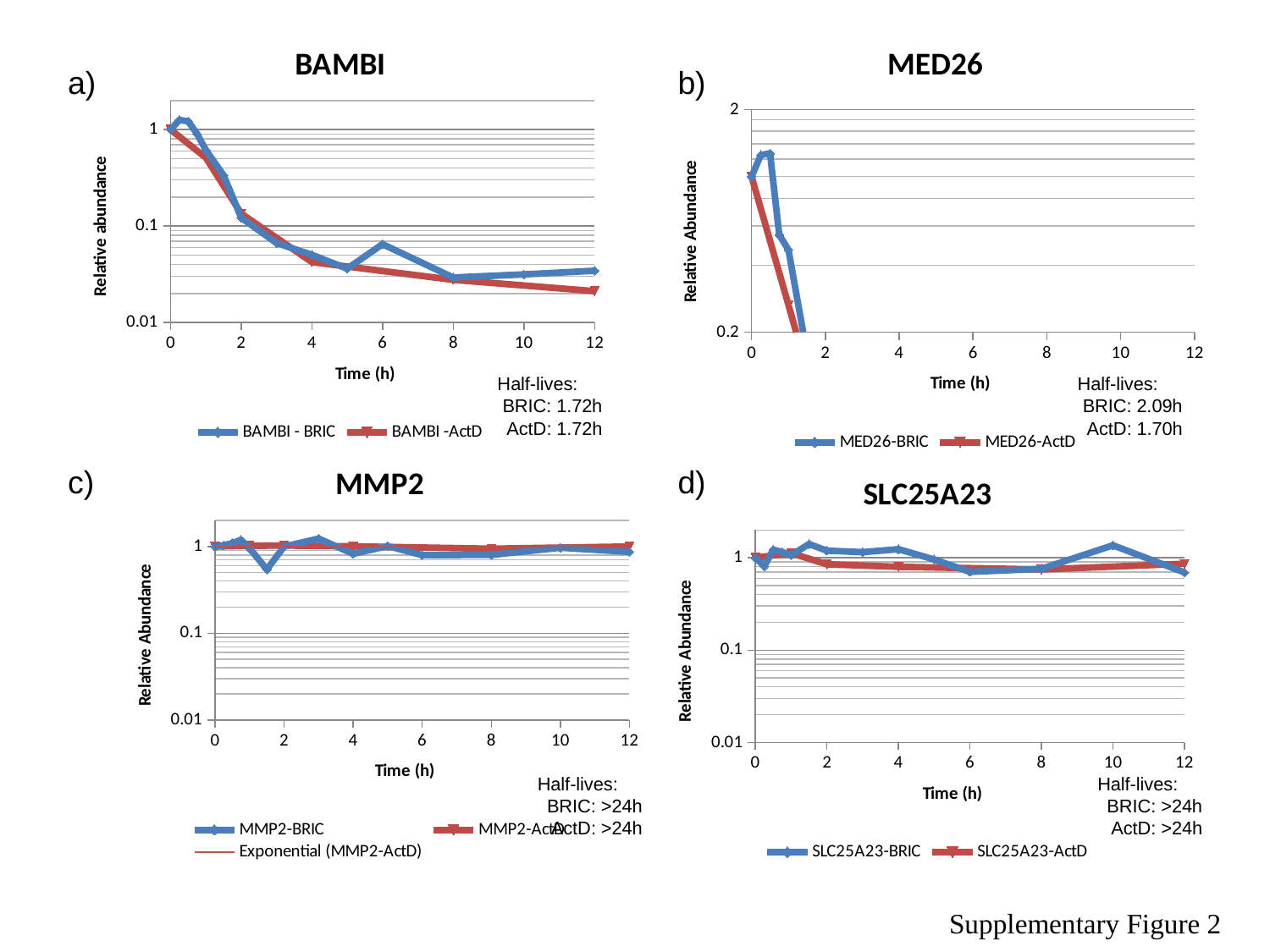
In the BAMBI chart, do the values rise or fall as time increases from 0 to 12 h? fall In the MED26 chart, do the plotted values rise or fall after 0.5 h? fall What is the x-axis label of the SLC25A23 chart? Time (h) In the SLC25A23 chart, is the SLC25A23-ActD value at 8 h greater or less than 0.1? greater In the BAMBI chart, is the BAMBI - BRIC value at 12 h greater or less than 0.1? less How many series does the legend of the SLC25A23 chart list? 2 In the BAMBI chart, at 6 h which series has the higher value, BAMBI - BRIC or BAMBI -ActD? BAMBI - BRIC How many series does the legend of the MMP2 chart list? 3 In the MMP2 chart, is the MMP2-BRIC value at 12 h greater or less than 0.1? greater In the MED26 chart, at 0.5 h which series has the higher value, MED26-BRIC or MED26-ActD? MED26-BRIC What kind of chart is the BAMBI chart? line chart